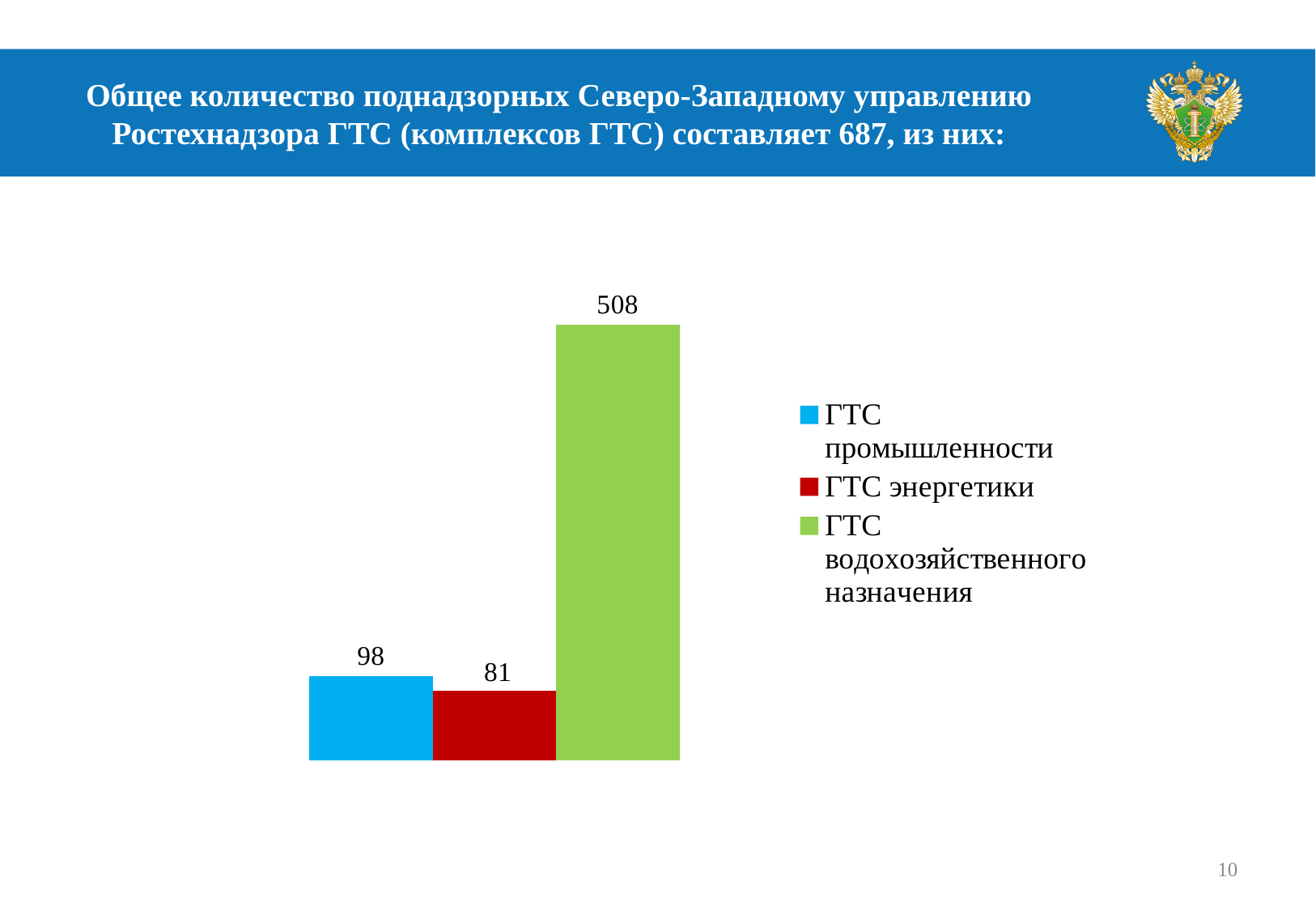
What is the difference between the values for ГТС водохозяйственного назначения and ГТС промышленности? 410 What is the difference between the values for ГТС промышленности and ГТС энергетики? 17 What is the total of the three bar values? 687 What is the value for ГТС водохозяйственного назначения? 508 What kind of chart is shown on the slide? bar chart What is the value for ГТС энергетики? 81 Which series has the lowest value? ГТС энергетики What is the value for ГТС промышленности? 98 Which is larger, the value for ГТС промышленности or the value for ГТС энергетики? ГТС промышленности How many series does the legend list? 3 What colour is the bar for ГТС энергетики? red Which series has the highest value? ГТС водохозяйственного назначения